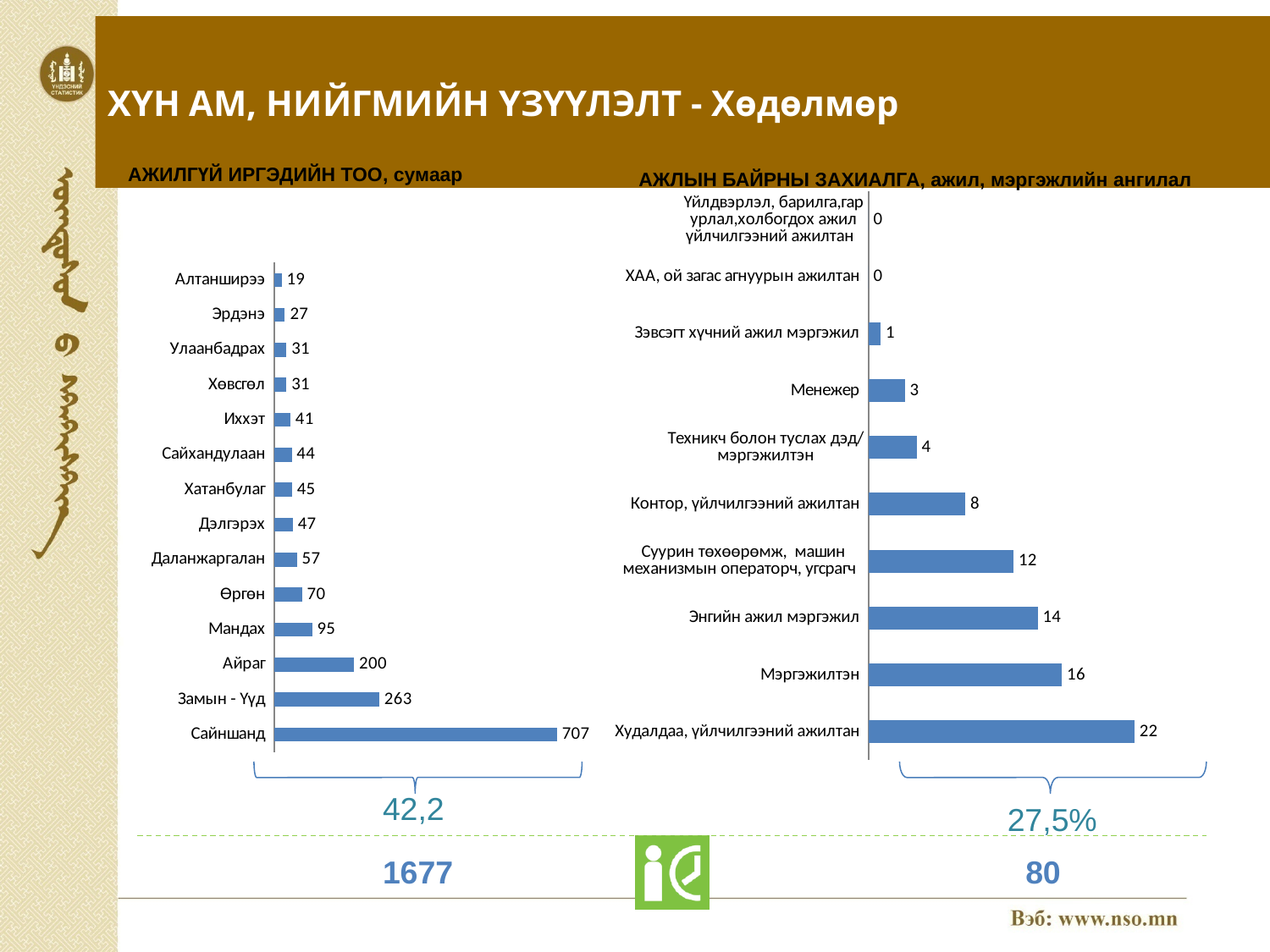
In the chart 'АЖЛЫН БАЙРНЫ ЗАХИАЛГА, ажил, мэргэжлийн ангилал', what is the difference between Худалдаа, үйлчилгээний ажилтан and Энгийн ажил мэргэжил? 8 In the chart 'АЖИЛГҮЙ ИРГЭДИЙН ТОО, сумаар', what is the difference between Замын - Үүд and Айраг? 63 What type of chart is 'АЖЛЫН БАЙРНЫ ЗАХИАЛГА, ажил, мэргэжлийн ангилал'? Bar chart In the chart 'АЖИЛГҮЙ ИРГЭДИЙН ТОО, сумаар', what is the value for Сайншанд? 707 In the chart 'АЖЛЫН БАЙРНЫ ЗАХИАЛГА, ажил, мэргэжлийн ангилал', what is the value for Мэргэжилтэн? 16 In the chart 'АЖЛЫН БАЙРНЫ ЗАХИАЛГА, ажил, мэргэжлийн ангилал', how many categories are shown? 10 In the chart 'АЖИЛГҮЙ ИРГЭДИЙН ТОО, сумаар', what is the value for Мандах? 95 In the chart 'АЖИЛГҮЙ ИРГЭДИЙН ТОО, сумаар', how many categories are shown? 14 In the chart 'АЖИЛГҮЙ ИРГЭДИЙН ТОО, сумаар', which is larger, Өргөн or Даланжаргалан? Өргөн In the chart 'АЖЛЫН БАЙРНЫ ЗАХИАЛГА, ажил, мэргэжлийн ангилал', which category has the highest value? Худалдаа, үйлчилгээний ажилтан In the chart 'АЖИЛГҮЙ ИРГЭДИЙН ТОО, сумаар', which category has the lowest value? Алтанширээ In the chart 'АЖЛЫН БАЙРНЫ ЗАХИАЛГА, ажил, мэргэжлийн ангилал', what is the value for Менежер? 3